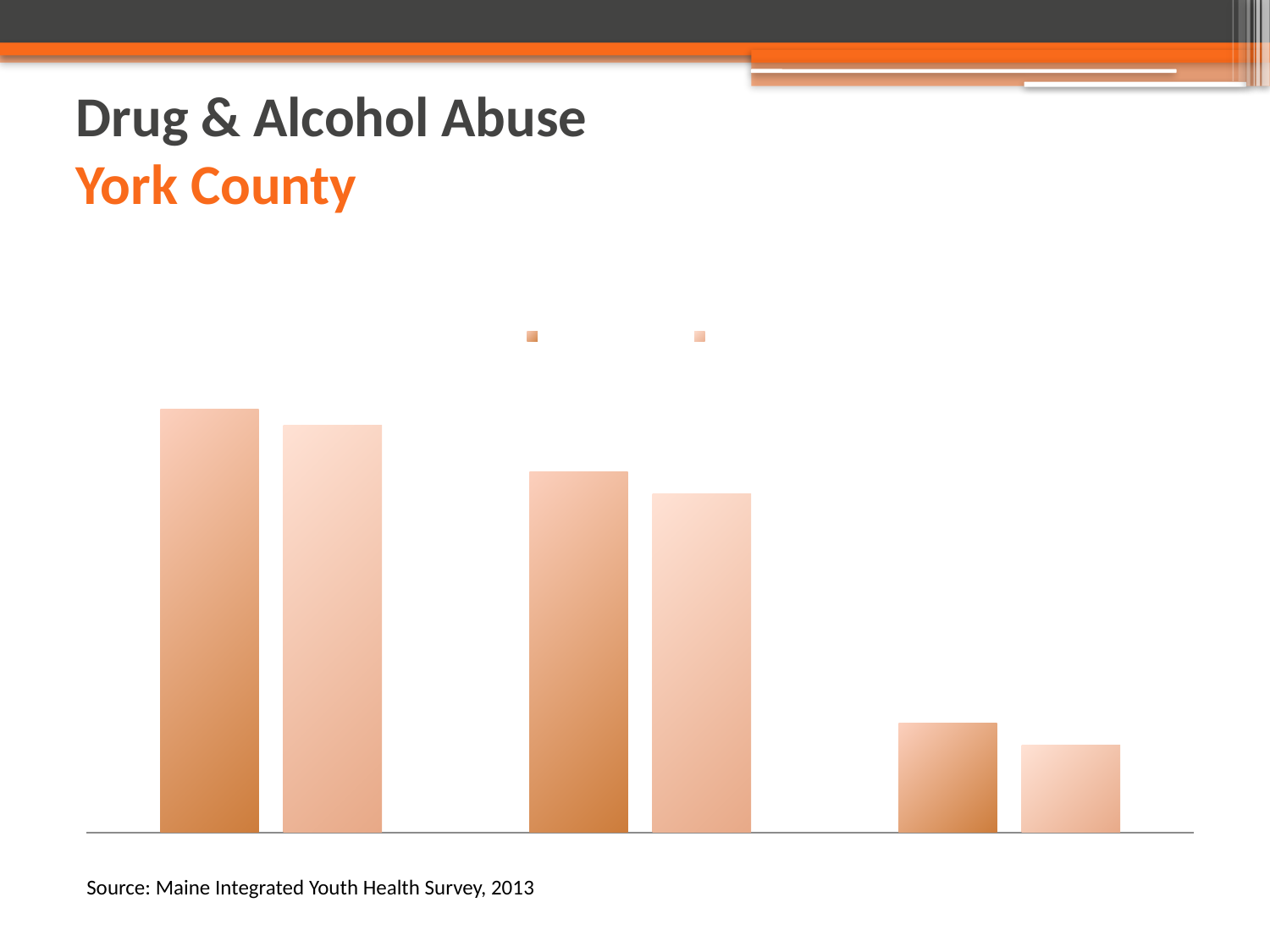
Which group of bars is the tallest: the left, middle, or right group? left Which group of bars is the shortest: the left, middle, or right group? right In the left group, is the darker bar or the lighter bar taller? darker In the right group, is the darker bar or the lighter bar taller? darker What is the title of the slide containing the chart? Drug & Alcohol Abuse York County What source is cited below the chart? Maine Integrated Youth Health Survey, 2013 Do the bar heights rise or fall from left to right across the groups? fall How many groups of bars does the chart show? 3 What kind of chart is shown on the slide? bar chart How many bars are plotted in total on the chart? 6 How many series does the legend list? 2 Is the darker bar in the middle group taller or shorter than the lighter bar in the left group? shorter